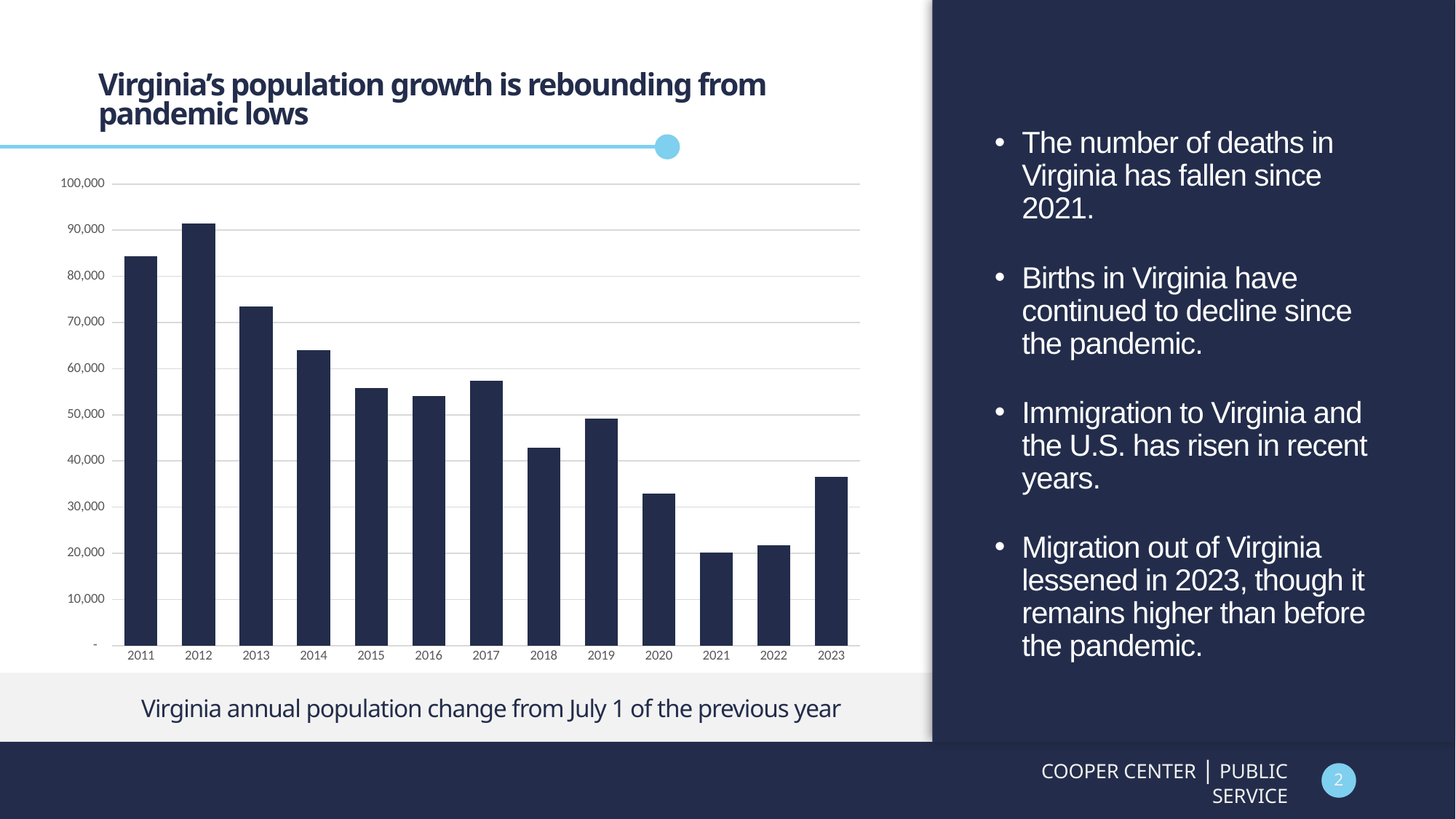
How many years are shown on the x axis of the chart? 13 Which year has the larger value, 2016 or 2017? 2017 Which year has the lowest annual population change in the chart? 2021 What kind of chart is shown on the slide? Bar chart Is the value for 2018 greater or less than 40,000? greater Which year has the highest annual population change in the chart? 2012 Is the value for 2013 greater or less than 70,000? greater Is the value for 2020 greater or less than 30,000? greater Do the values rise or fall from 2011 to 2016? Fall What caption appears below the chart? Virginia annual population change from July 1 of the previous year